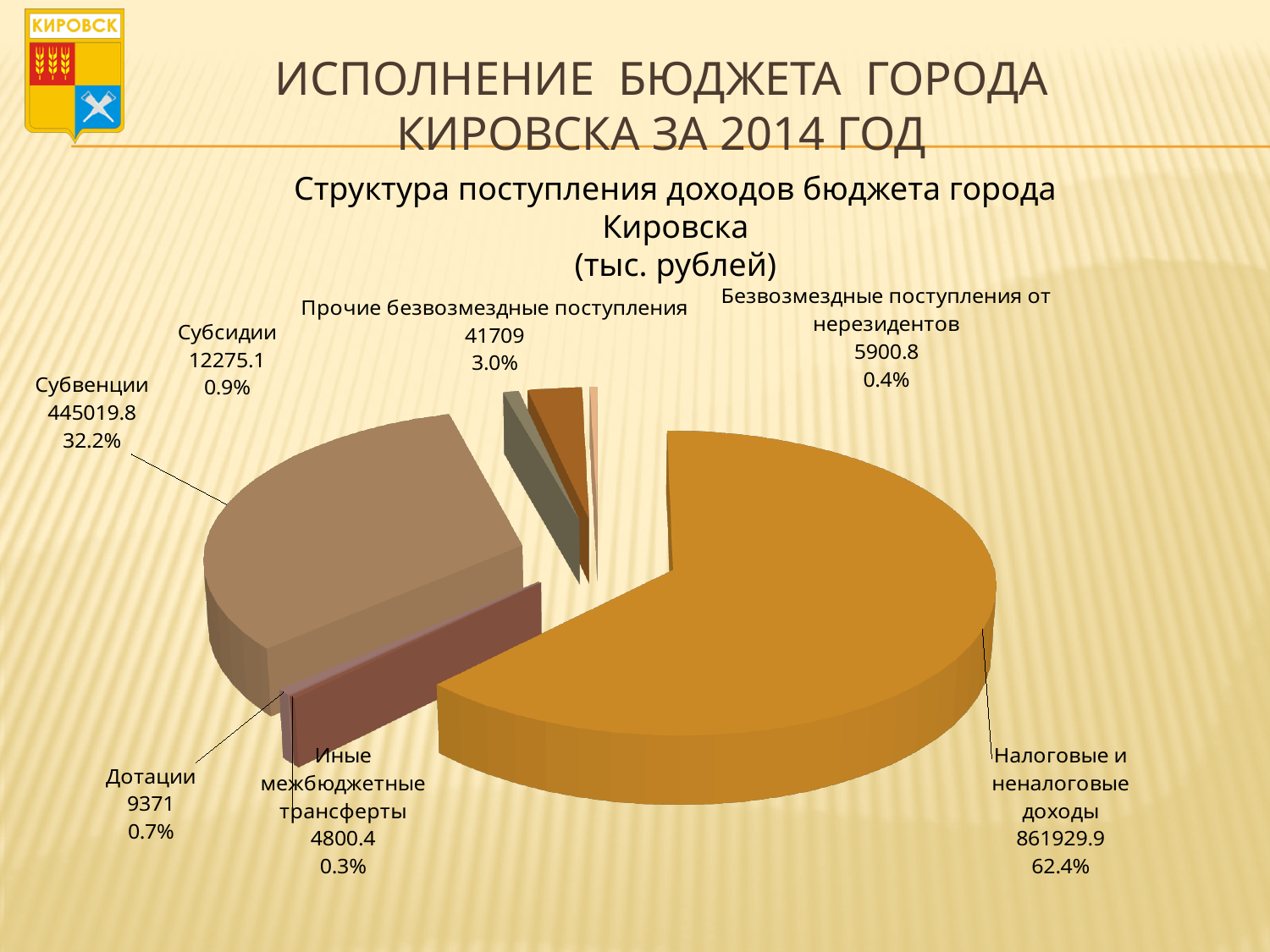
How many categories are shown in the pie chart? 7 What is the value for Субвенции? 445019.8 What share of the pie does Субвенции represent? 32.2% What is the difference between the values for Субсидии and Дотации? 2904.1 Which is larger, Субсидии or Дотации? Субсидии Which category has the smallest slice? Иные межбюджетные трансферты What is the value for Прочие безвозмездные поступления? 41709 What type of chart is shown on the slide? pie chart What is the value for Иные межбюджетные трансферты? 4800.4 Which category has the largest slice? Налоговые и неналоговые доходы What is the value for Налоговые и неналоговые доходы? 861929.9 What share of the pie does Безвозмездные поступления от нерезидентов represent? 0.4%